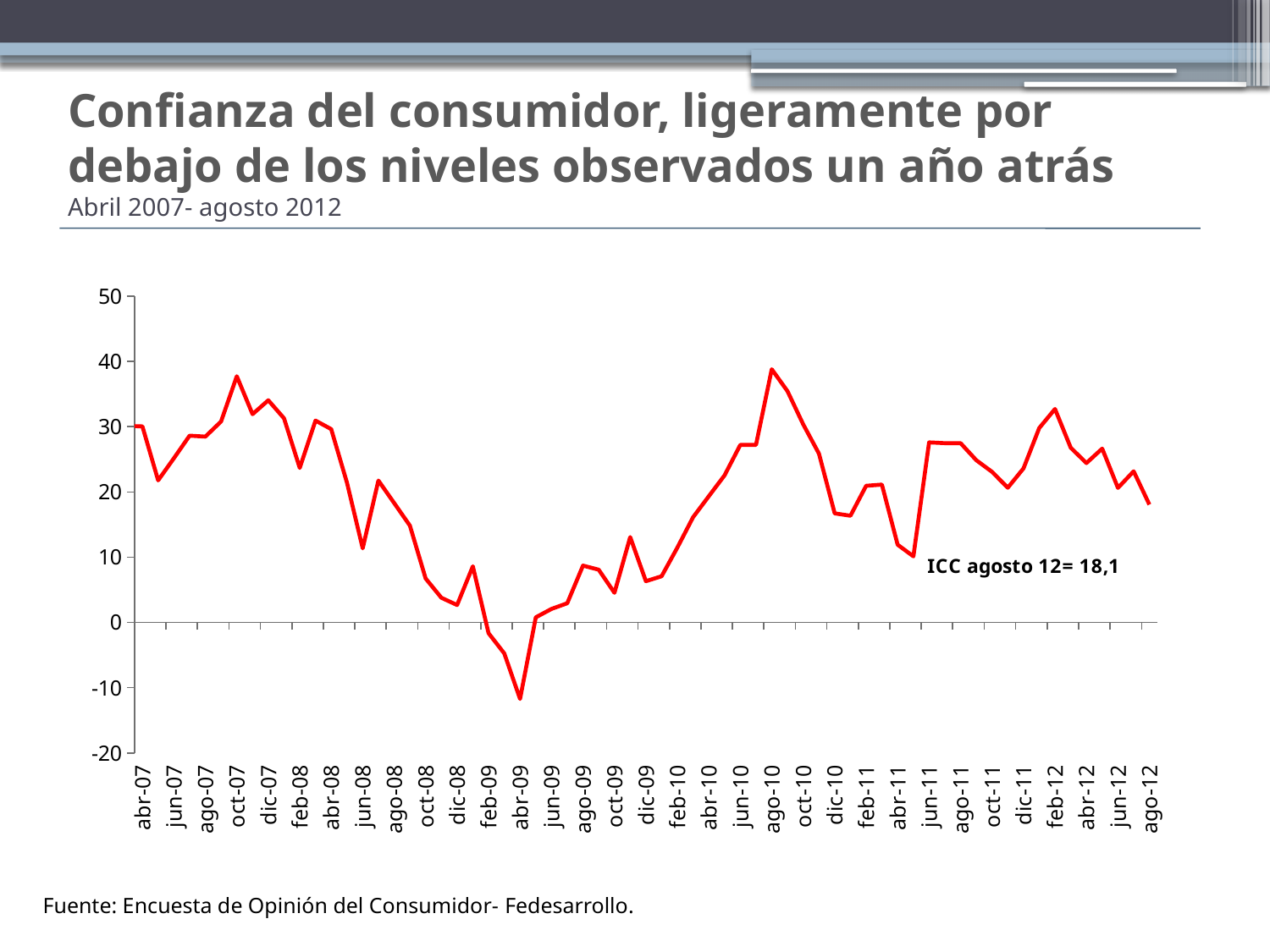
Do the values rise or fall between feb-12 and ago-12? fall Which is larger, the value for feb-12 or the value for ago-12? feb-12 Which is larger, the value for oct-07 or the value for jun-08? oct-07 Is the value for jun-08 greater or less than 20? less Is the value for ago-10 greater or less than 30? greater What is the ICC value for agosto 2012 (ago-12) according to the label on the chart? 18,1 What period does the chart cover according to the subtitle? Abril 2007- agosto 2012 What kind of chart is shown on the slide? line chart Do the values rise or fall between abr-09 and ago-10? rise Which month shows the lowest value on the chart? abr-09 Is the value for abr-09 greater or less than 0? less